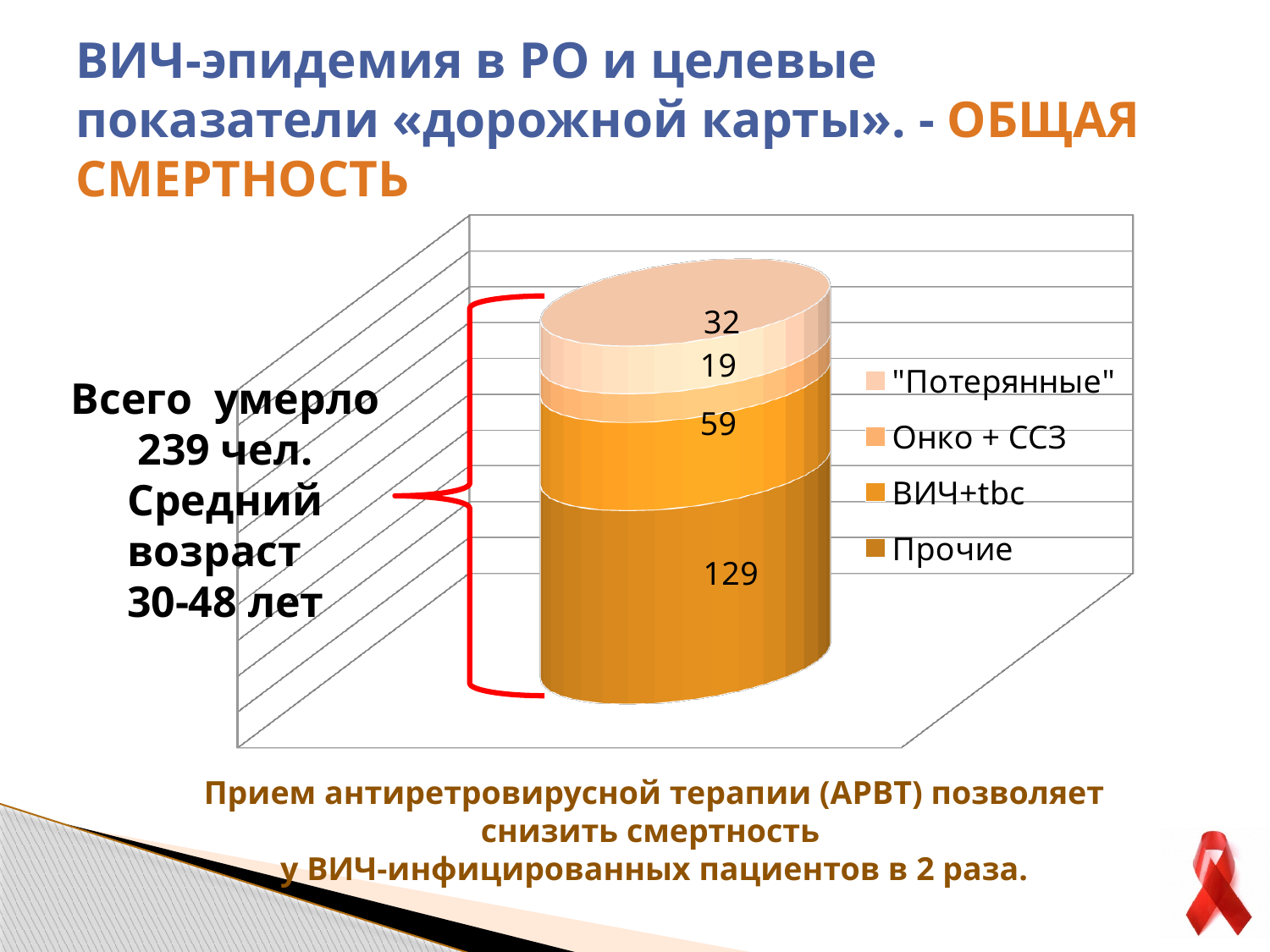
What kind of chart is shown on the slide? Stacked bar chart What is the total of all segments in the stacked bar? 239 Which segment of the stacked bar has the smallest value? Онко + ССЗ What is the value for the "Потерянные" segment of the stacked bar? 32 What is the value for the "ВИЧ+tbc" segment of the stacked bar? 59 What is the difference between the "Потерянные" and "Онко + ССЗ" values? 13 Which segment of the stacked bar has the largest value? Прочие How many series does the legend list? 4 What is the difference between the "Прочие" and "ВИЧ+tbc" values? 70 What is the value for the "Прочие" segment of the stacked bar? 129 What is the value for the "Онко + ССЗ" segment of the stacked bar? 19 Which is larger, the "ВИЧ+tbc" value or the "Потерянные" value? ВИЧ+tbc